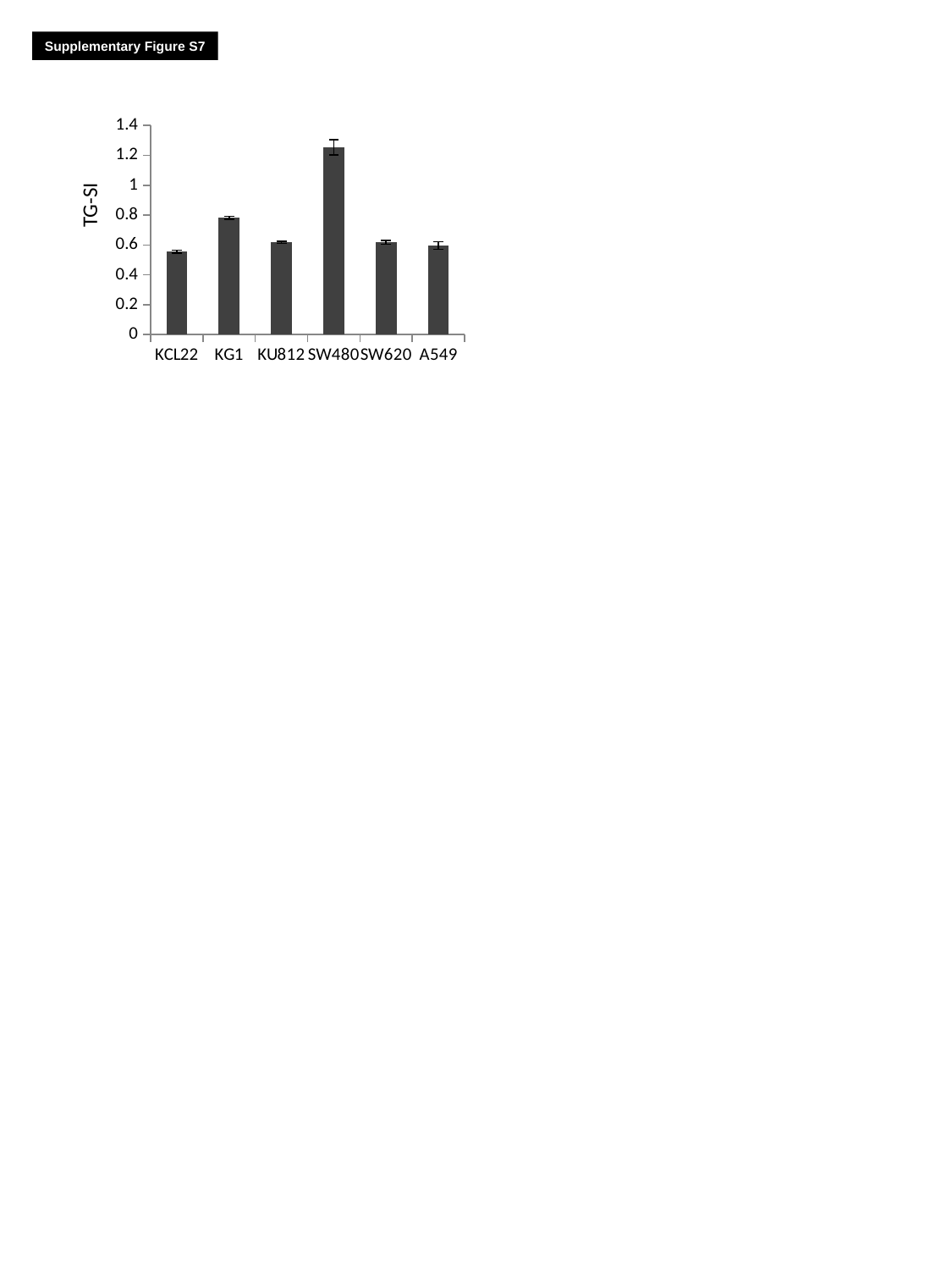
What kind of chart is shown on the slide? bar chart Is the TG-SI value for KG1 greater or less than 0.6? greater What is the label on the y axis of the chart? TG-SI What is the figure label shown at the top of the slide? Supplementary Figure S7 Which has the larger TG-SI value, KG1 or A549? KG1 Which has the larger TG-SI value, KG1 or KU812? KG1 Is the TG-SI value for A549 greater or less than 0.8? less Which has the larger TG-SI value, SW480 or KG1? SW480 Which category has the highest TG-SI value? SW480 How many cell lines (categories) are plotted on the x axis? 6 Is the TG-SI value for SW480 greater or less than 1? greater